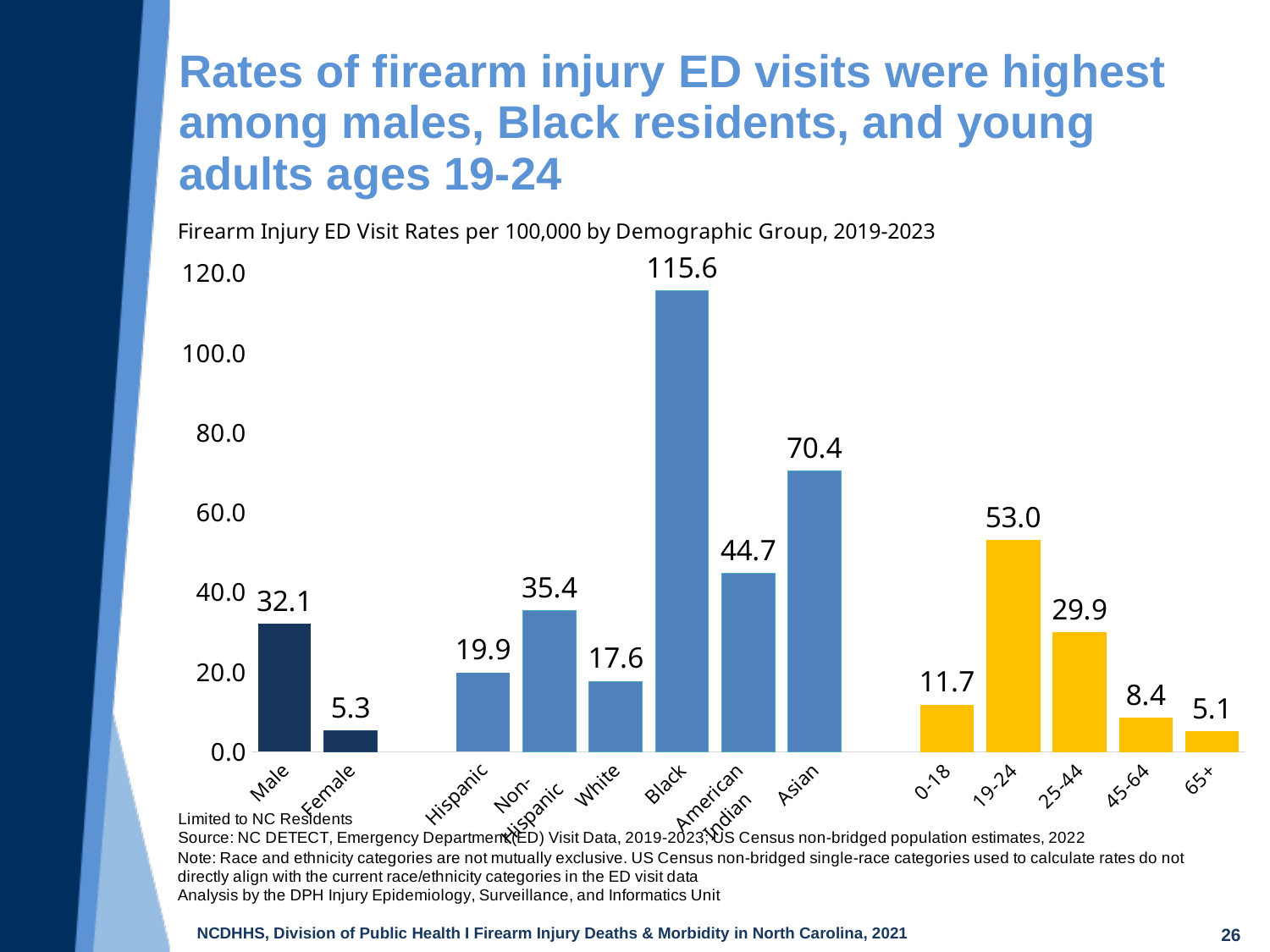
Which demographic group has the lowest firearm injury ED visit rate? 65+ Which has a higher firearm injury ED visit rate, Hispanic or Non-Hispanic residents? Non-Hispanic What is the firearm injury ED visit rate per 100,000 for the 19-24 age group? 53.0 What is the difference between the firearm injury ED visit rates for males and females? 26.8 What is the firearm injury ED visit rate per 100,000 for Asian residents? 70.4 Which has a higher firearm injury ED visit rate, White residents or American Indian residents? American Indian What is the difference between the firearm injury ED visit rates for the 19-24 and 25-44 age groups? 23.1 What is the firearm injury ED visit rate per 100,000 for Black residents? 115.6 How many demographic groups are shown in the chart? 13 Which demographic group has the highest firearm injury ED visit rate? Black What is the firearm injury ED visit rate per 100,000 for males? 32.1 What type of chart is used to show firearm injury ED visit rates by demographic group? Bar chart